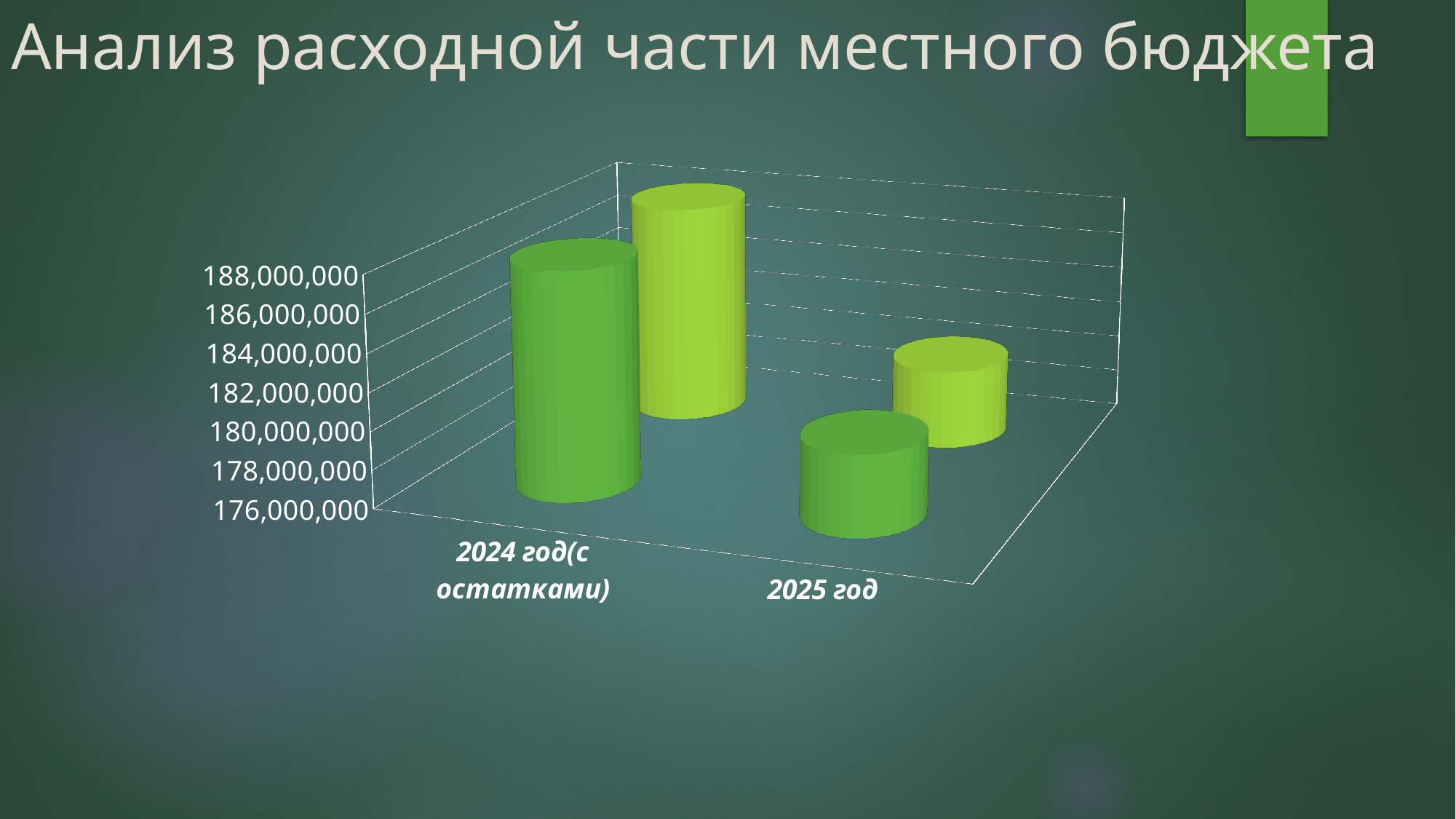
What kind of chart is shown on the slide? bar chart Which category has the lowest dark green bar in the chart? 2025 год Which category has the taller dark green bar, "2024 год(с остатками)" or "2025 год"? 2024 год(с остатками) Do the values fall or rise from "2024 год(с остатками)" to "2025 год"? fall Which category has the taller light green bar, "2024 год(с остатками)" or "2025 год"? 2024 год(с остатками) What is the title of the slide containing the chart? Анализ расходной части местного бюджета How many bars are plotted in the chart in total? 4 What is the highest value shown on the vertical axis of the chart? 188,000,000 Is the dark green bar for "2025 год" greater or less than 186,000,000? less How many categories are shown on the x axis of the chart? 2 Which category has the highest light green bar in the chart? 2024 год(с остатками) Is the dark green bar for "2024 год(с остатками)" greater or less than 182,000,000? greater